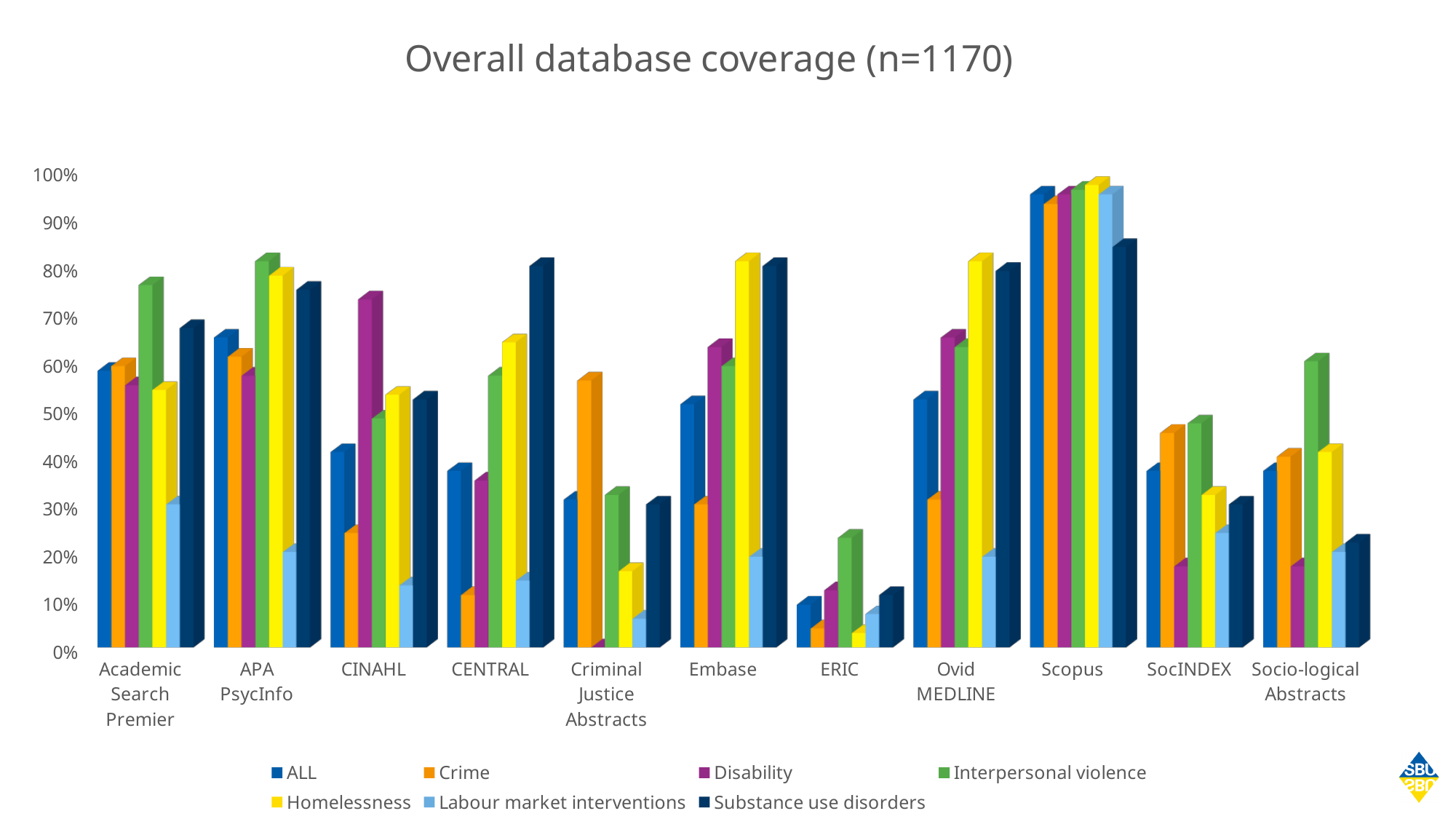
What is the title of the chart? Overall database coverage (n=1170) How many databases (categories) are shown on the x axis? 11 Which database has the highest value for the ALL series? Scopus Which database has the lowest value for the ALL series? ERIC Is the ALL value for ERIC greater or less than 20%? less Is the ALL value for Scopus greater or less than 90%? greater How many series does the legend list? 7 Is the Crime value for Criminal Justice Abstracts greater or less than 50%? greater For CINAHL, which is larger: the Disability value or the ALL value? Disability For Academic Search Premier, which is larger: the Interpersonal violence value or the Crime value? Interpersonal violence What kind of chart is shown on the slide? bar chart